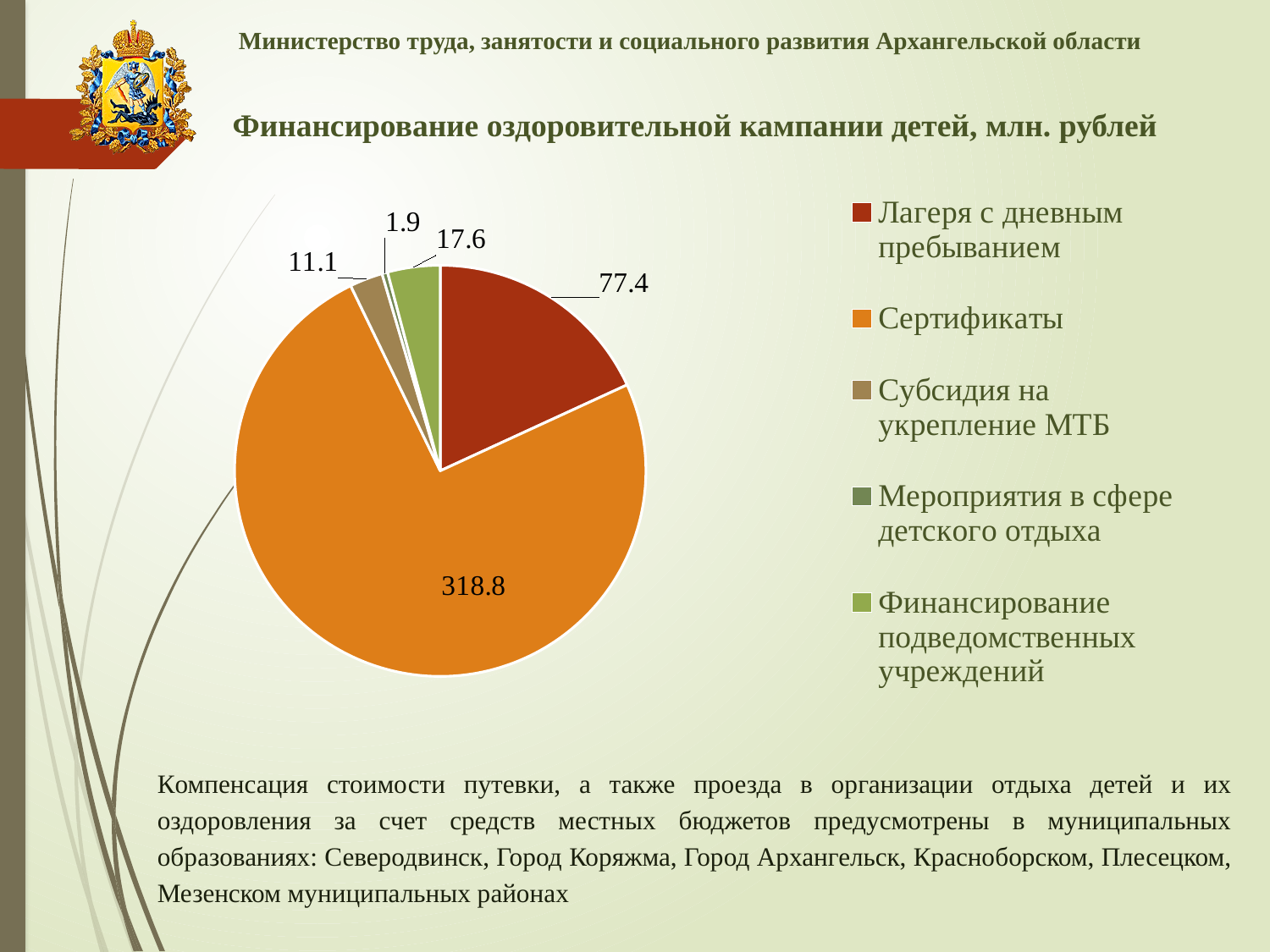
Which category has the smallest slice? Мероприятия в сфере детского отдыха What is the value for Сертификаты? 318.8 What type of chart is shown on the slide? pie chart What is the value for Лагеря с дневным пребыванием? 77.4 Which is larger: Финансирование подведомственных учреждений or Субсидия на укрепление МТБ? Финансирование подведомственных учреждений What is the title of the chart? Финансирование оздоровительной кампании детей, млн. рублей What is the value for Субсидия на укрепление МТБ? 11.1 What is the value for Мероприятия в сфере детского отдыха? 1.9 What is the difference between the values for Сертификаты and Лагеря с дневным пребыванием? 241.4 What is the value for Финансирование подведомственных учреждений? 17.6 How many categories does the pie chart show? 5 Which category has the largest slice? Сертификаты